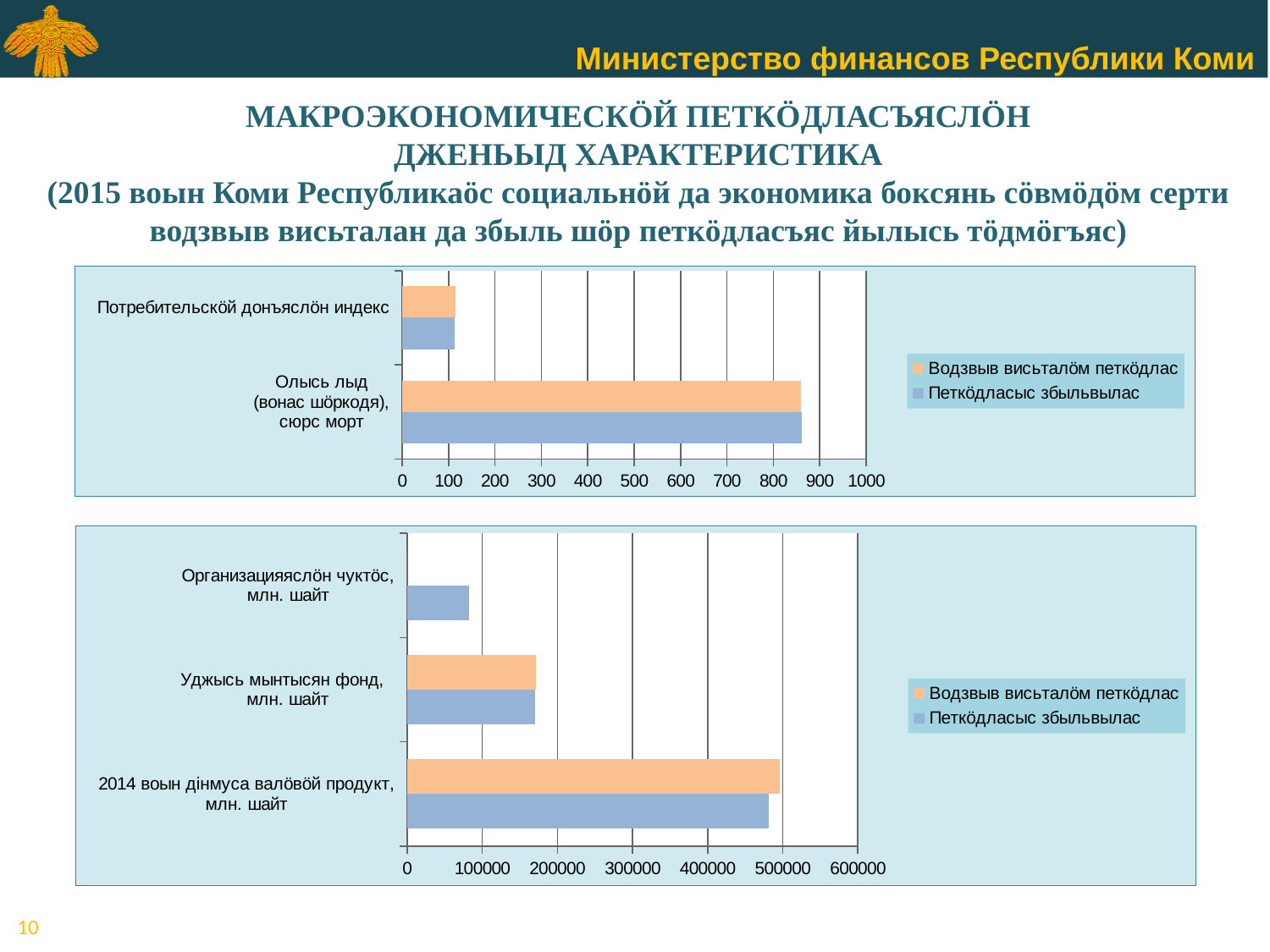
How many series does the legend of the top chart list? 2 In the top chart, which category has the highest values? Олысь лыд (вонас шöркодя), сюрс морт In the bottom chart, is the value of Петкöдласыс збыльвылас for Организацияяслöн чуктöс, млн. шайт greater or less than 100000? less What kind of chart is the top chart on the slide? bar chart How many categories does the top chart show? 2 How many categories does the bottom chart show? 3 What kind of chart is the bottom chart on the slide? bar chart In the bottom chart, is the value of Водзвыв висьталöм петкöдлас for 2014 воын дінмуса валöвöй продукт, млн. шайт greater or less than 400000? greater In the top chart, is the value of Водзвыв висьталöм петкöдлас for Потребительскöй донъяслöн индекс greater or less than 200? less In the bottom chart, which series is shown in orange? Водзвыв висьталöм петкöдлас In the bottom chart, which category has the highest values? 2014 воын дінмуса валöвöй продукт, млн. шайт